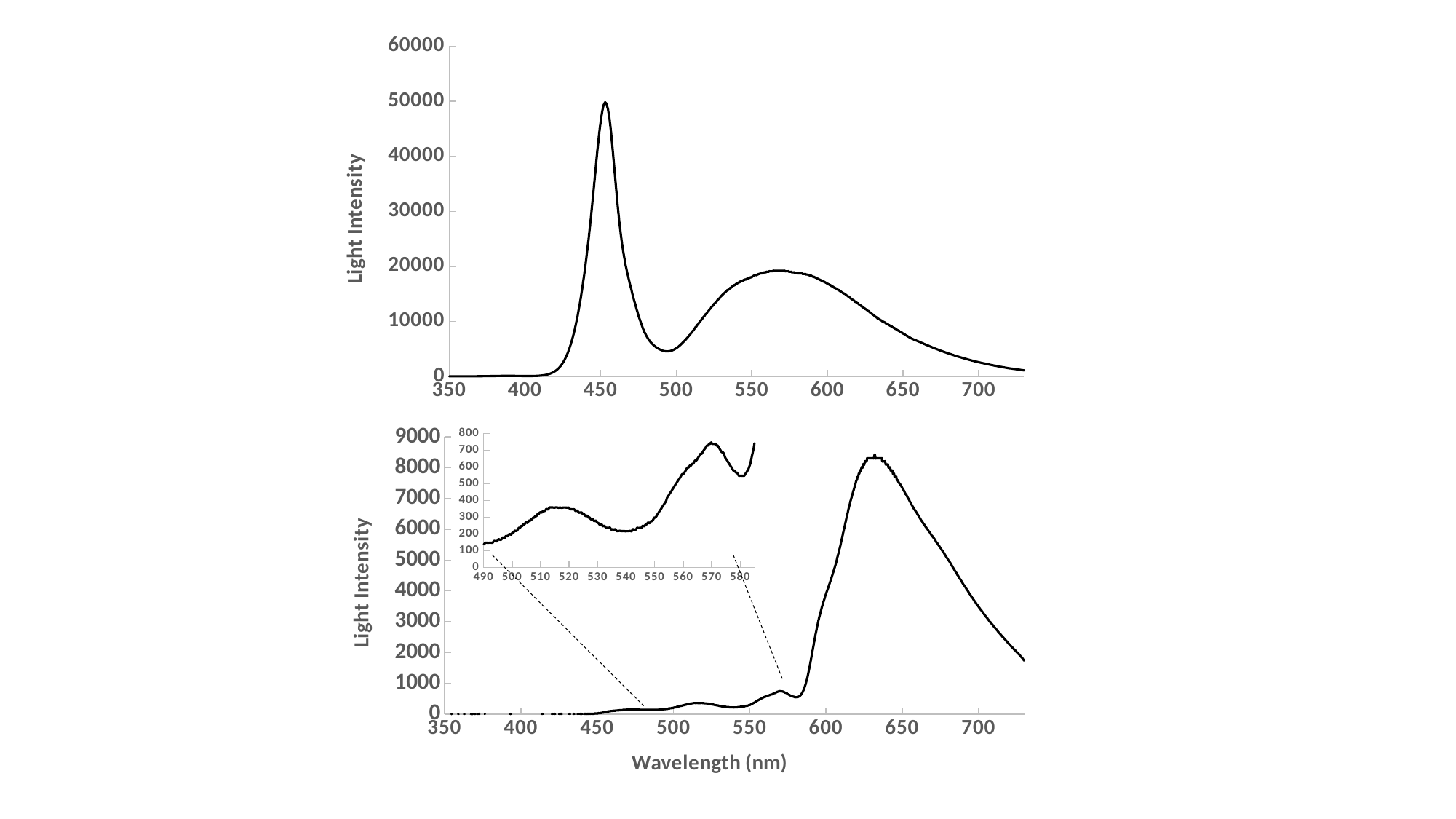
What is the label of the y axis on the top chart? Light Intensity In the top chart, is the peak value near 450 nm greater or less than 40000? greater In the top chart, is the value of the broad peak near 570 nm greater or less than 20000? less In the top chart, do the values rise or fall as wavelength increases from 600 nm to 700 nm? fall What is the label of the x axis shown below the bottom chart? Wavelength (nm) In the bottom chart, is the peak value near 630 nm greater or less than 8000? greater In the bottom chart, do the values rise or fall as wavelength increases from 590 nm to 630 nm? rise In the top chart, which is larger: the peak near 450 nm or the peak near 570 nm? the peak near 450 nm What kind of chart is the top chart on the slide? line chart